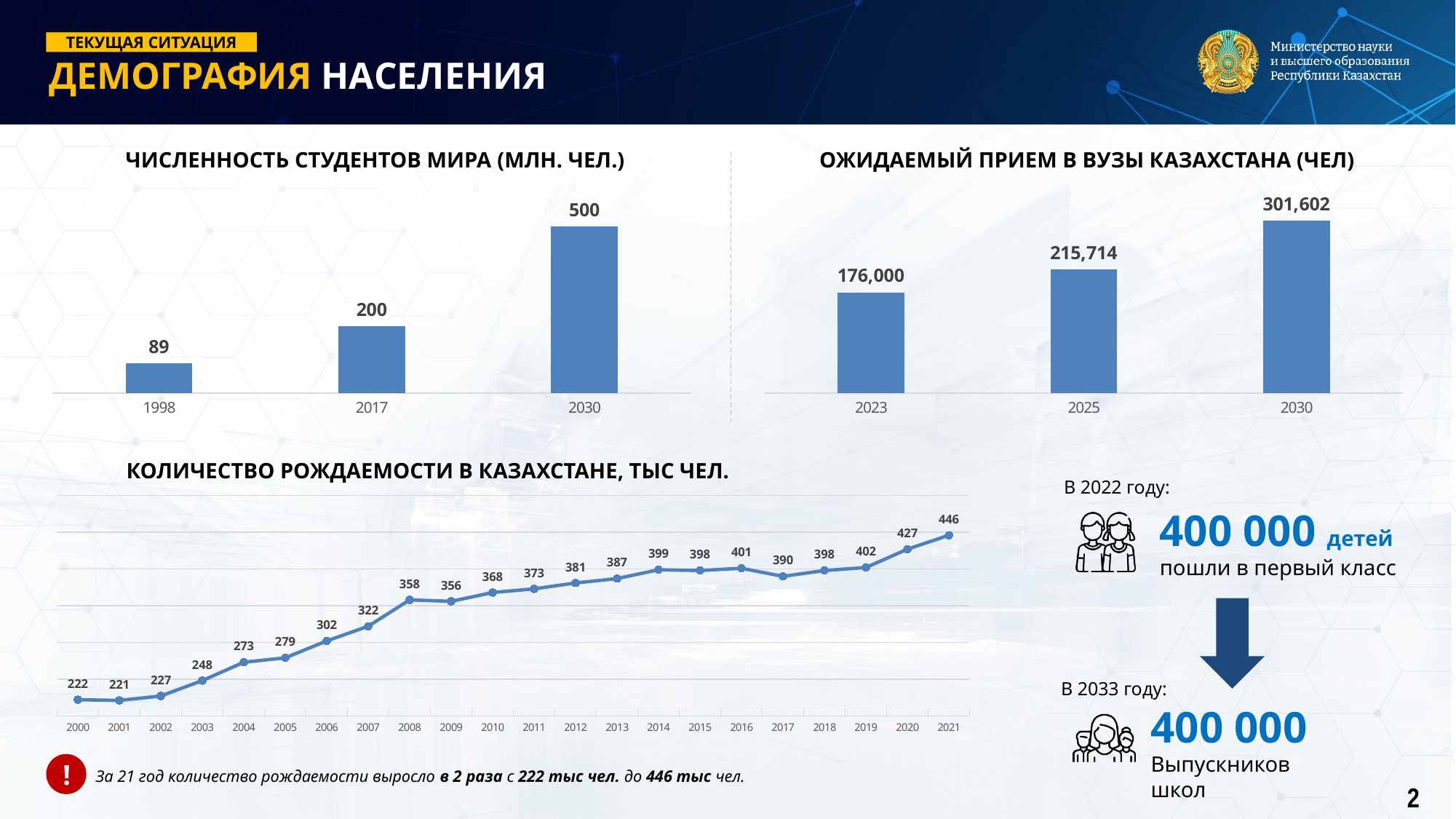
In the chart titled 'КОЛИЧЕСТВО РОЖДАЕМОСТИ В КАЗАХСТАНЕ, ТЫС ЧЕЛ.', which year has the highest value? 2021 In the chart titled 'ОЖИДАЕМЫЙ ПРИЕМ В ВУЗЫ КАЗАХСТАНА (ЧЕЛ)', how many bars are shown? 3 What kind of chart is the one titled 'КОЛИЧЕСТВО РОЖДАЕМОСТИ В КАЗАХСТАНЕ, ТЫС ЧЕЛ.'? Line chart In the chart titled 'ОЖИДАЕМЫЙ ПРИЕМ В ВУЗЫ КАЗАХСТАНА (ЧЕЛ)', what is the value for 2025? 215,714 In the chart titled 'ОЖИДАЕМЫЙ ПРИЕМ В ВУЗЫ КАЗАХСТАНА (ЧЕЛ)', which year has the highest value? 2030 In the chart titled 'ЧИСЛЕННОСТЬ СТУДЕНТОВ МИРА (МЛН. ЧЕЛ.)', what is the value for 2017? 200 In the chart titled 'КОЛИЧЕСТВО РОЖДАЕМОСТИ В КАЗАХСТАНЕ, ТЫС ЧЕЛ.', what is the value for 2008? 358 In the chart titled 'ЧИСЛЕННОСТЬ СТУДЕНТОВ МИРА (МЛН. ЧЕЛ.)', which year has the lowest value? 1998 What kind of chart is the one titled 'ЧИСЛЕННОСТЬ СТУДЕНТОВ МИРА (МЛН. ЧЕЛ.)'? Bar chart In the chart titled 'ЧИСЛЕННОСТЬ СТУДЕНТОВ МИРА (МЛН. ЧЕЛ.)', what is the difference between the values for 2030 and 2017? 300 In the chart titled 'ОЖИДАЕМЫЙ ПРИЕМ В ВУЗЫ КАЗАХСТАНА (ЧЕЛ)', what is the difference between the values for 2030 and 2023? 125,602 In the chart titled 'КОЛИЧЕСТВО РОЖДАЕМОСТИ В КАЗАХСТАНЕ, ТЫС ЧЕЛ.', which is larger, the value for 2016 or the value for 2017? 2016